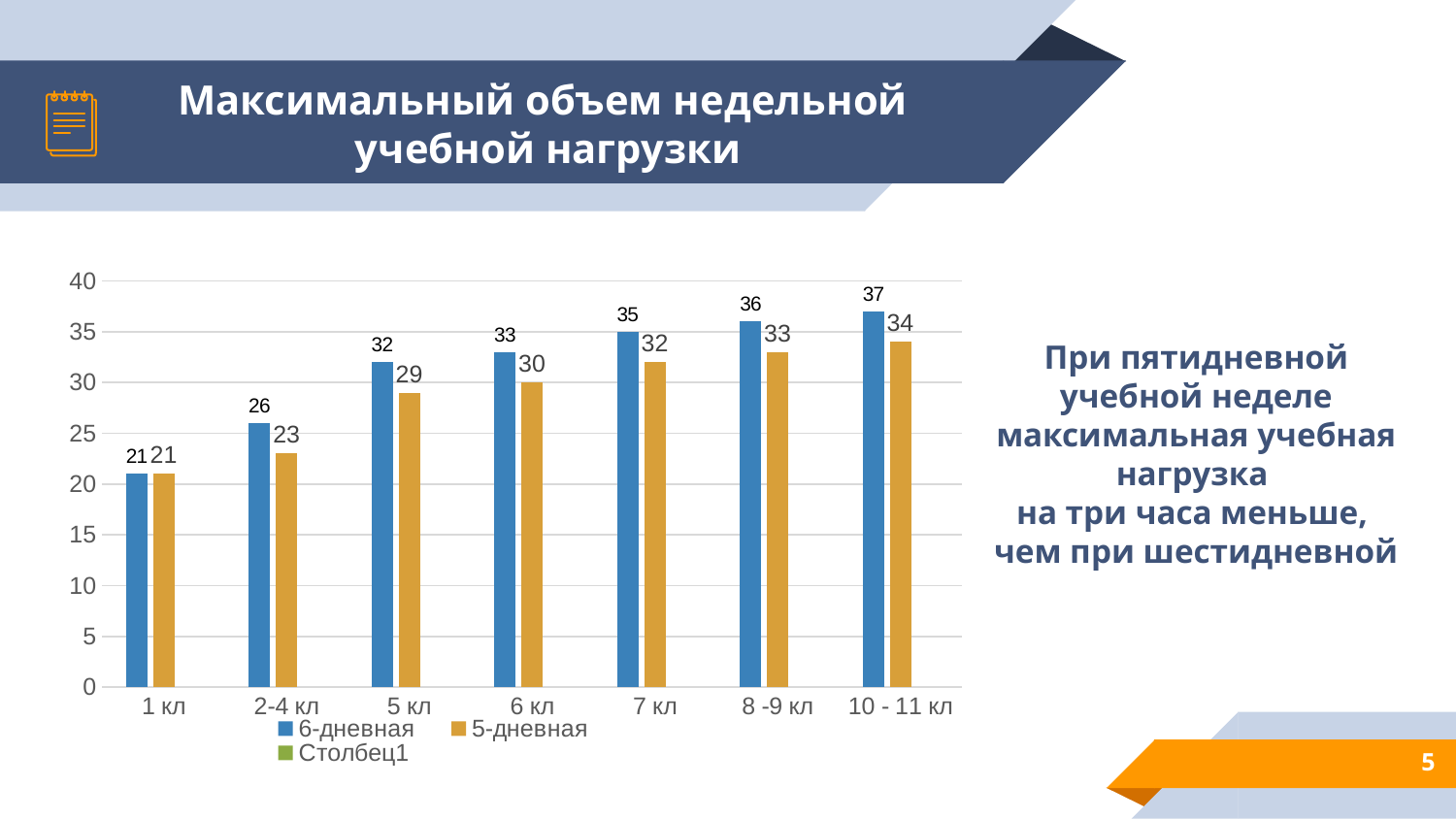
Which category has the highest value for the 6-дневная series? 10 - 11 кл Which is larger at 6 кл: the 6-дневная value or the 5-дневная value? 6-дневная What kind of chart is shown on the slide? bar chart Do the 5-дневная values rise or fall from 1 кл to 10 - 11 кл? rise How many categories are shown on the x axis? 7 How many series does the legend list? 3 What colour are the bars for the 5-дневная series? orange What is the difference between the 6-дневная and 5-дневная values at 7 кл? 3 What is the value for 5-дневная at 8 -9 кл? 33 What is the value for 6-дневная at 5 кл? 32 What is the value for 5-дневная at 2-4 кл? 23 Which category has the lowest value for the 5-дневная series? 1 кл